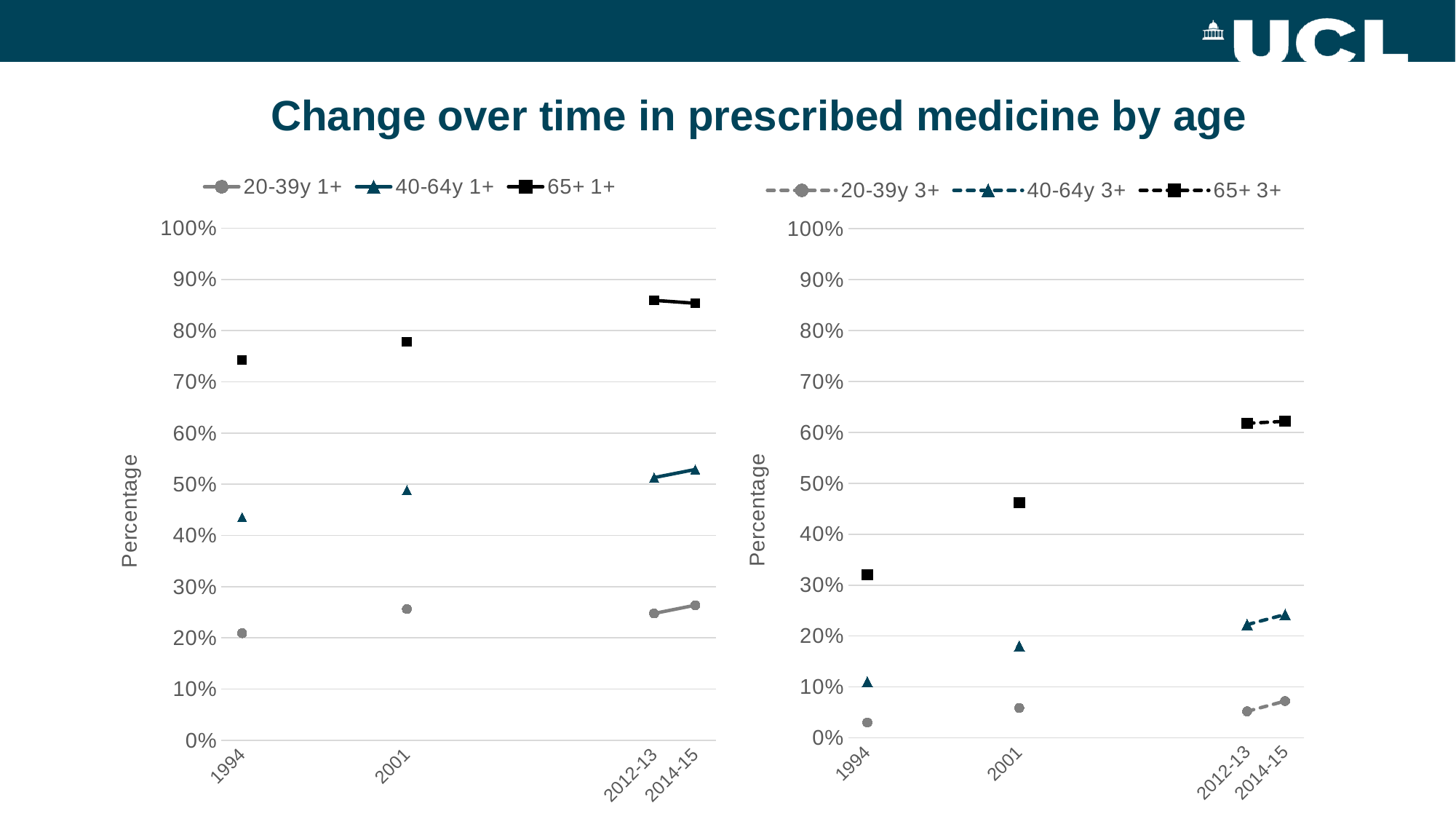
In the left chart, is the value for 40-64y 1+ in 2001 greater or less than 40%? greater In the right chart, which series has the lowest value in 1994? 20-39y 3+ How many time points are shown on the x axis of the right chart? 4 In the left chart, does the value for 65+ 1+ rise or fall from 1994 to 2012-13? rise In the right chart, is the value for 65+ 3+ in 2012-13 greater or less than 50%? greater What kind of chart is the left chart? Line chart How many series does the legend of the left chart list? 3 In the left chart, which is larger in 2001: the value for 40-64y 1+ or the value for 20-39y 1+? 40-64y 1+ How many series does the legend of the right chart list? 3 In the left chart, which series has the highest value in 2014-15? 65+ 1+ In the left chart, is the value for 65+ 1+ in 1994 greater or less than 70%? greater